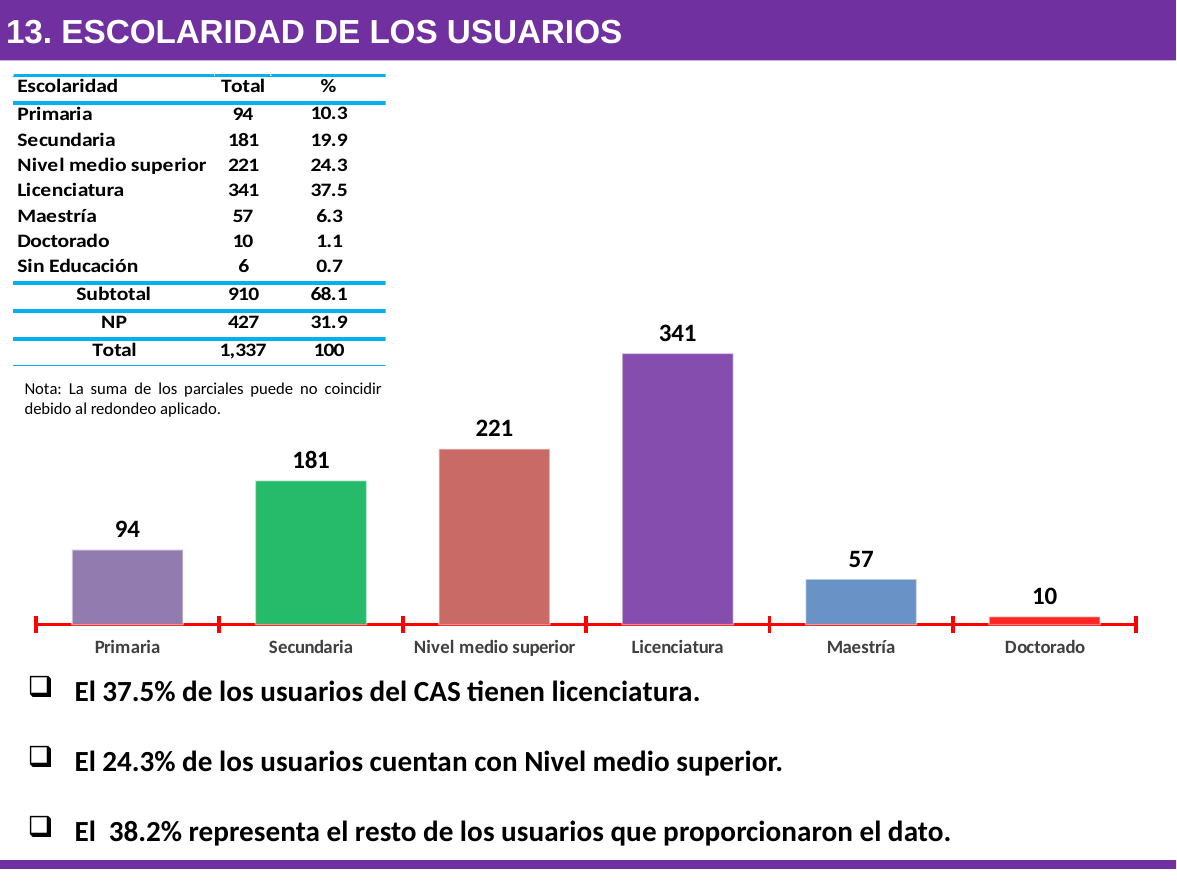
Do the values rise or fall from Licenciatura to Doctorado along the x axis? fall What kind of chart is shown on the slide? bar chart What is the value for Maestría in the bar chart? 57 What is the value for Secundaria in the bar chart? 181 Which category has the lowest value in the bar chart? Doctorado Which is larger, the value for Primaria or the value for Maestría? Primaria What is the value for Licenciatura in the bar chart? 341 Which category has the highest value in the bar chart? Licenciatura What is the difference between the values for Licenciatura and Nivel medio superior? 120 How many categories are shown in the bar chart? 6 What is the difference between the values for Secundaria and Primaria? 87 What is the value for Nivel medio superior in the bar chart? 221